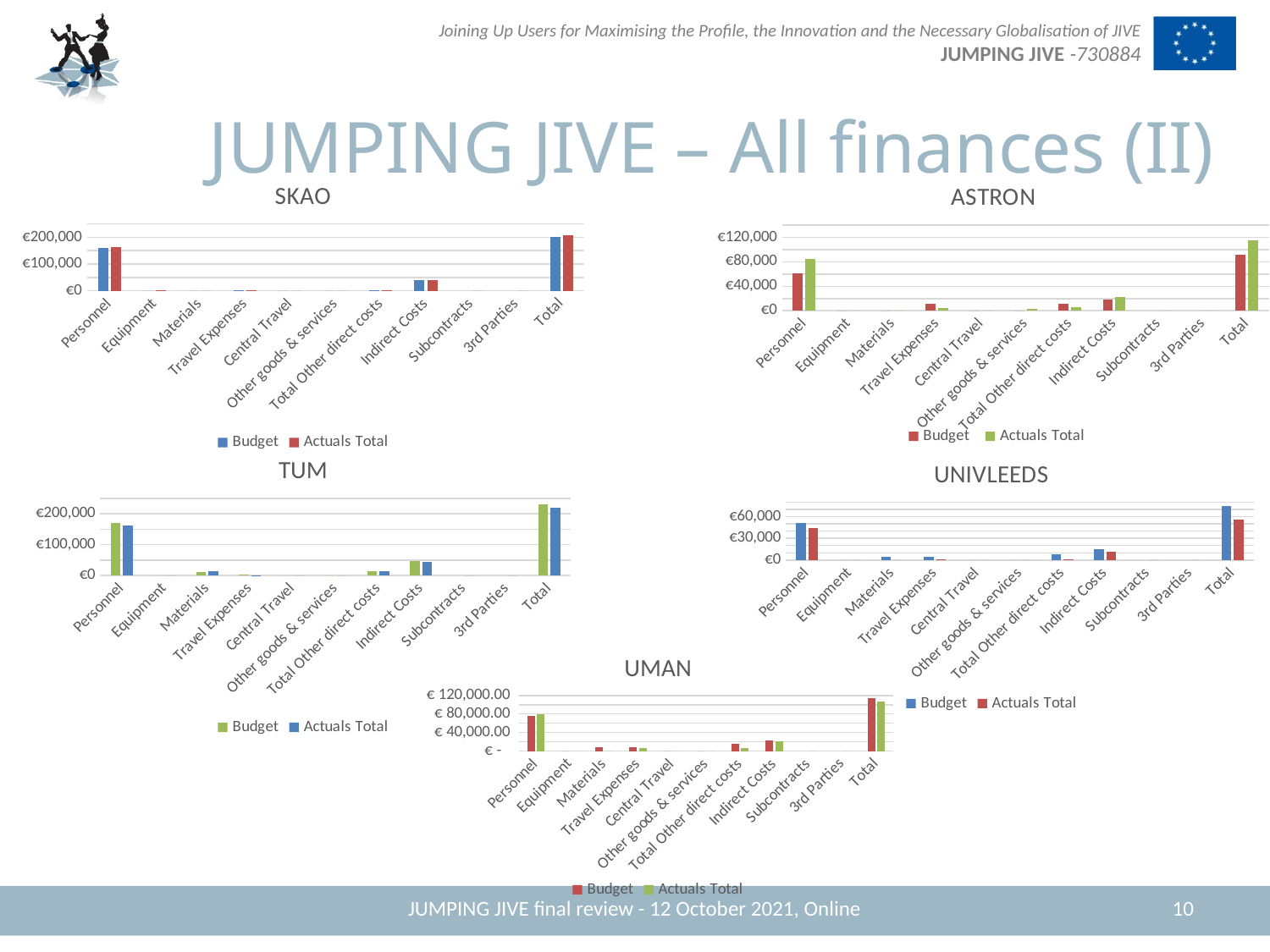
How many categories are shown on the x axis of the ASTRON chart? 11 How many series does the legend of the SKAO chart list? 2 In the ASTRON chart, which is larger for Personnel: Budget or Actuals Total? Actuals Total In the UMAN chart, is the Budget value for Total greater or less than € 80,000.00? greater How many charts are shown on the slide? 5 In the SKAO chart, is the Budget value for Indirect Costs greater or less than €100,000? less In the UNIVLEEDS chart, is the Budget value for Personnel greater or less than €30,000? greater What kind of chart is the SKAO chart? bar chart In the SKAO chart, which category has the highest Actuals Total value? Total In the UNIVLEEDS chart, which category has the highest Budget value? Total